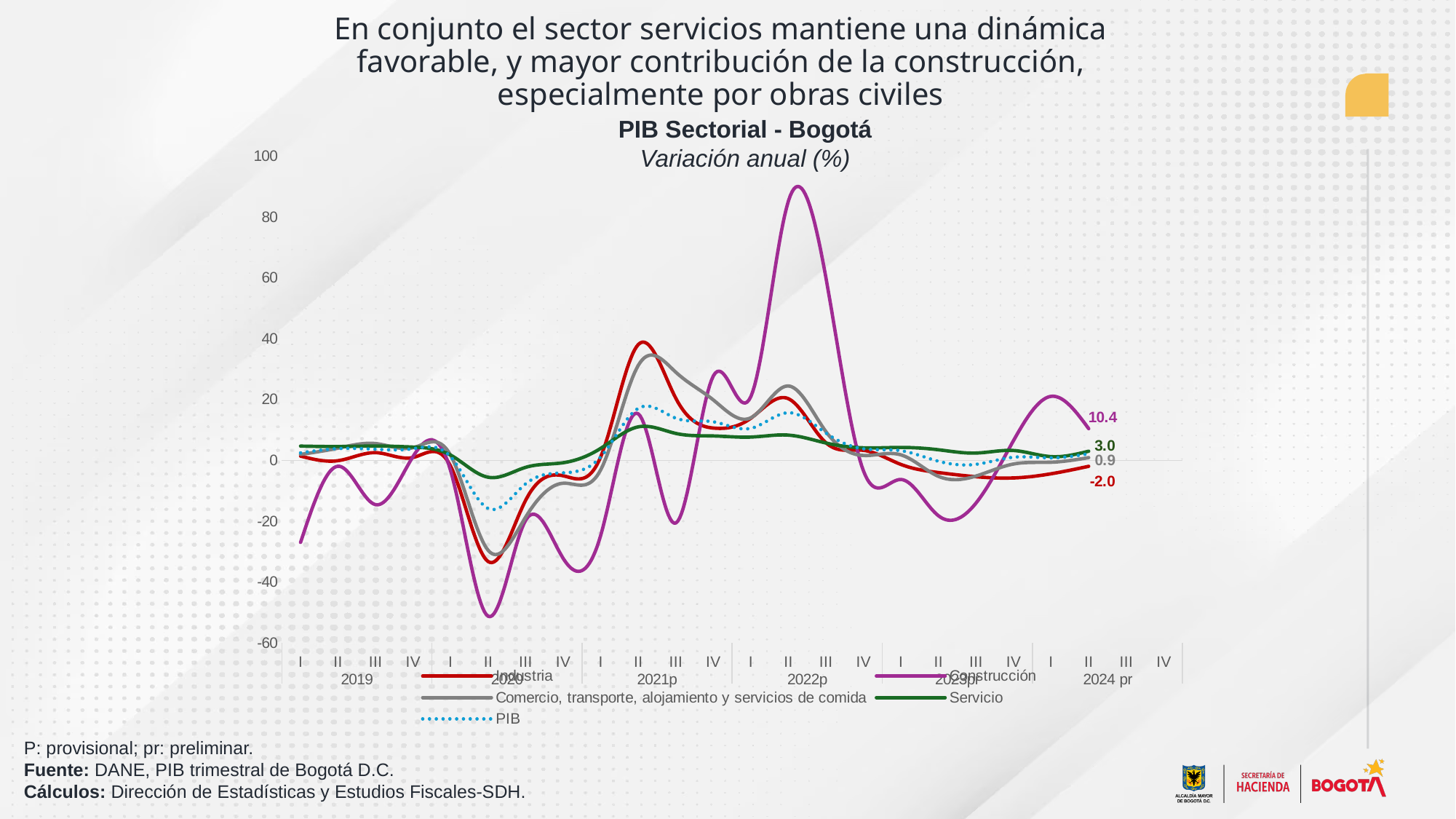
What kind of chart is shown on the slide? line chart What is the latest labelled value for Servicio in the PIB Sectorial - Bogotá chart? 3.0 Is the peak value of Construcción in 2022p greater or less than 80? greater What is the subtitle shown under the chart title PIB Sectorial - Bogotá? Variación anual (%) What is the difference between the latest labelled values of Construcción and Servicio? 7.4 What is the latest labelled value for Comercio, transporte, alojamiento y servicios de comida? 0.9 What is the latest labelled value for Construcción in the PIB Sectorial - Bogotá chart? 10.4 Which series has the highest latest labelled value in the PIB Sectorial - Bogotá chart? Construcción How many series does the legend of the PIB Sectorial - Bogotá chart list? 5 Which has the larger latest labelled value, Servicio or Industria? Servicio What is the latest labelled value for Industria in the PIB Sectorial - Bogotá chart? -2.0 Which series has the lowest latest labelled value in the PIB Sectorial - Bogotá chart? Industria